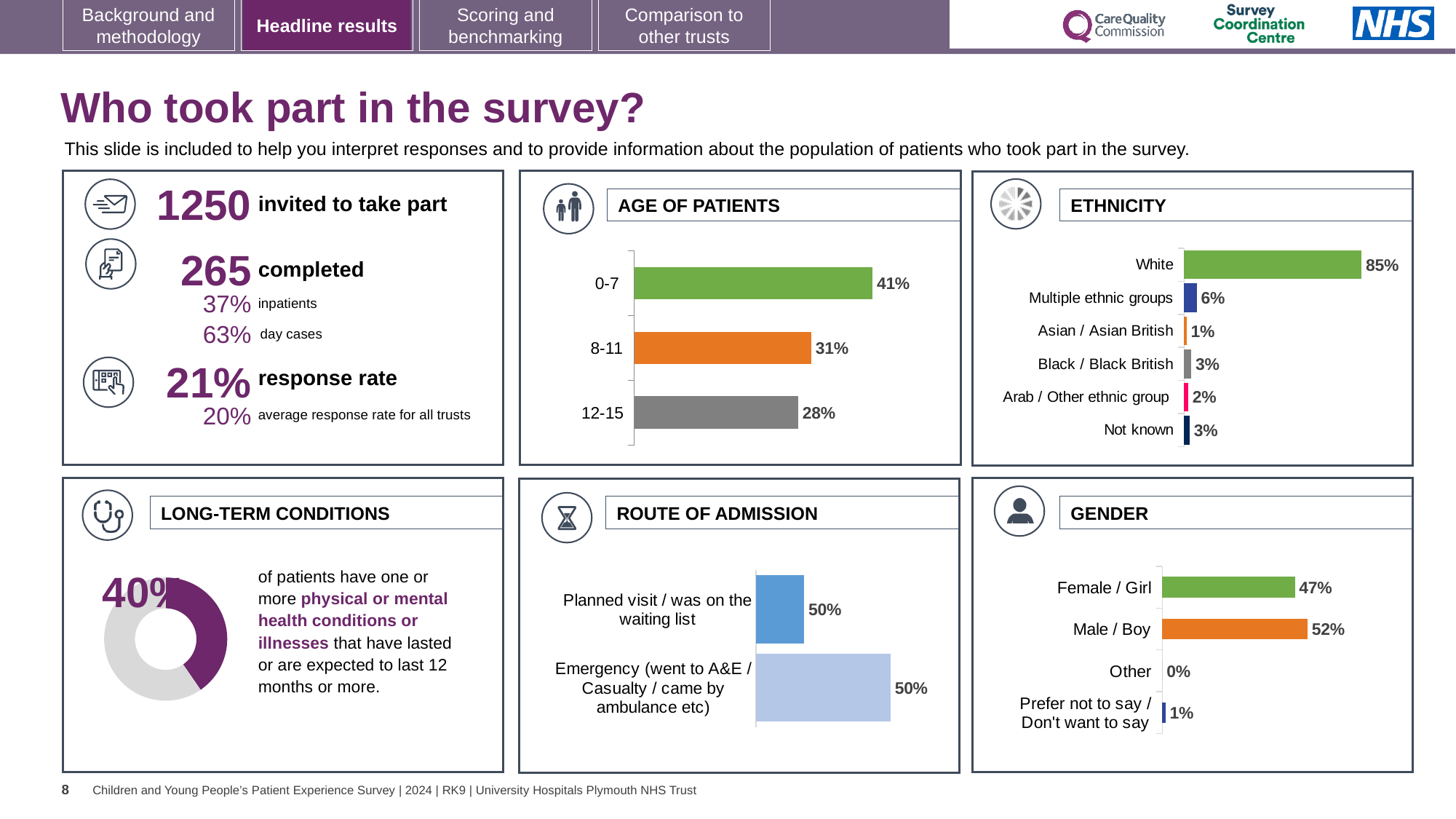
In the ETHNICITY chart, which is larger: Multiple ethnic groups or Asian / Asian British? Multiple ethnic groups In the ETHNICITY chart, which category has the highest percentage? White In the GENDER chart, what percentage of patients were Male / Boy? 52% In the ROUTE OF ADMISSION chart, what percentage of patients came via Emergency (went to A&E / Casualty / came by ambulance etc)? 50% How many categories are shown in the ETHNICITY chart? 6 In the GENDER chart, which is larger: Female / Girl or Male / Boy? Male / Boy In the LONG-TERM CONDITIONS chart, what share of patients have one or more physical or mental health conditions? 40% In the AGE OF PATIENTS chart, which age group has the lowest percentage? 12-15 In the ETHNICITY chart, what percentage of patients were White? 85% In the AGE OF PATIENTS chart, what is the difference between the 0-7 and 8-11 percentages? 10% What kind of chart is used in the LONG-TERM CONDITIONS panel? Donut chart In the AGE OF PATIENTS chart, what percentage of patients were aged 0-7? 41%